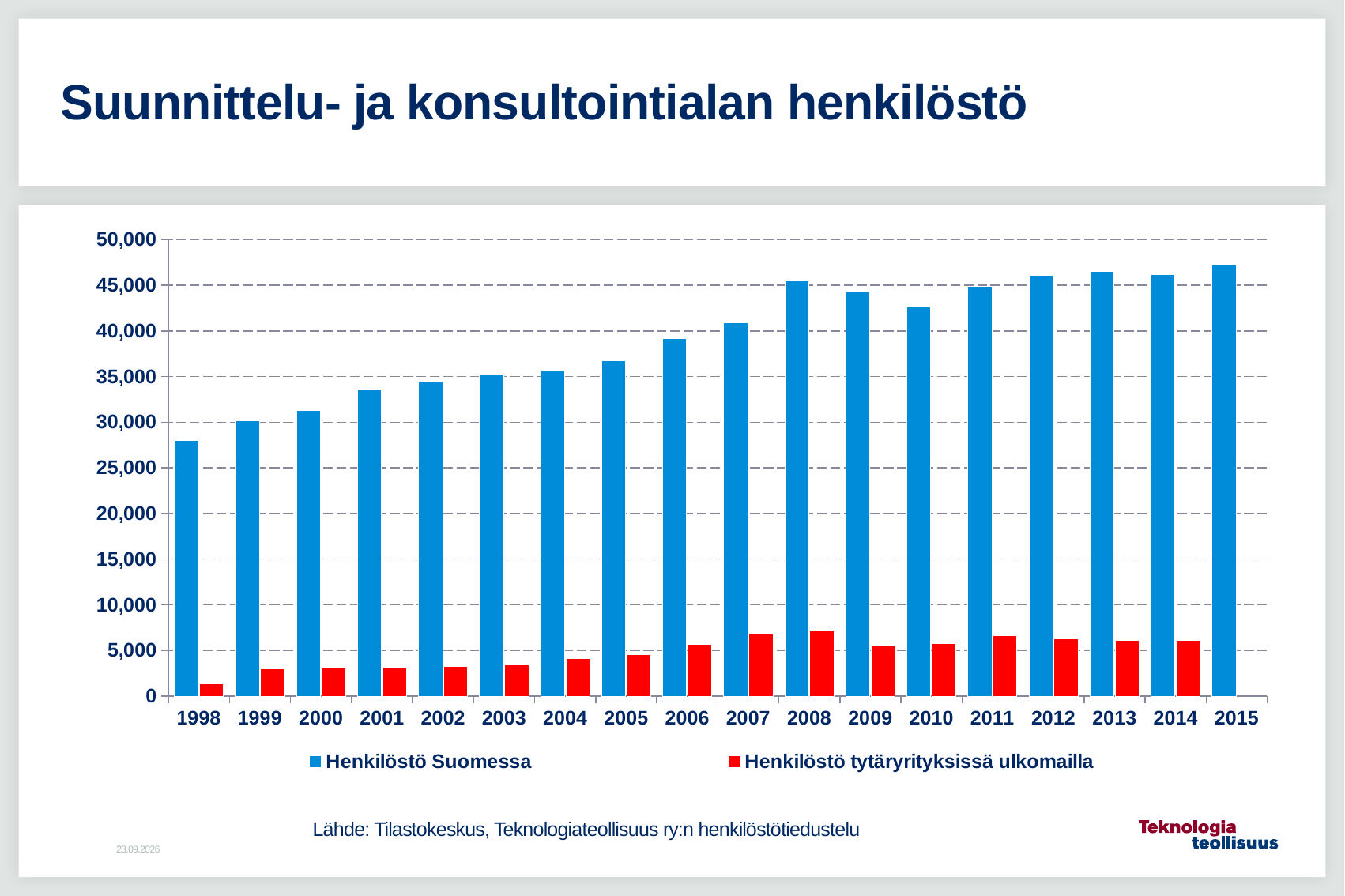
Is the value for Henkilöstö Suomessa in 1998 greater or less than 30,000? less How many series does the legend list? 2 What is the title of the slide? Suunnittelu- ja konsultointialan henkilöstö What kind of chart is shown on the slide? bar chart Which year has the highest value for Henkilöstö Suomessa? 2015 Is the value for Henkilöstö tytäryrityksissä ulkomailla in 2008 greater or less than 5,000? greater Is the value for Henkilöstö Suomessa in 2015 greater or less than 45,000? greater Which year has the lowest value for Henkilöstö Suomessa? 1998 How many years are shown on the x axis? 18 Which year has the lowest value for Henkilöstö tytäryrityksissä ulkomailla? 1998 Which is larger, Henkilöstö Suomessa in 2008 or in 2010? 2008